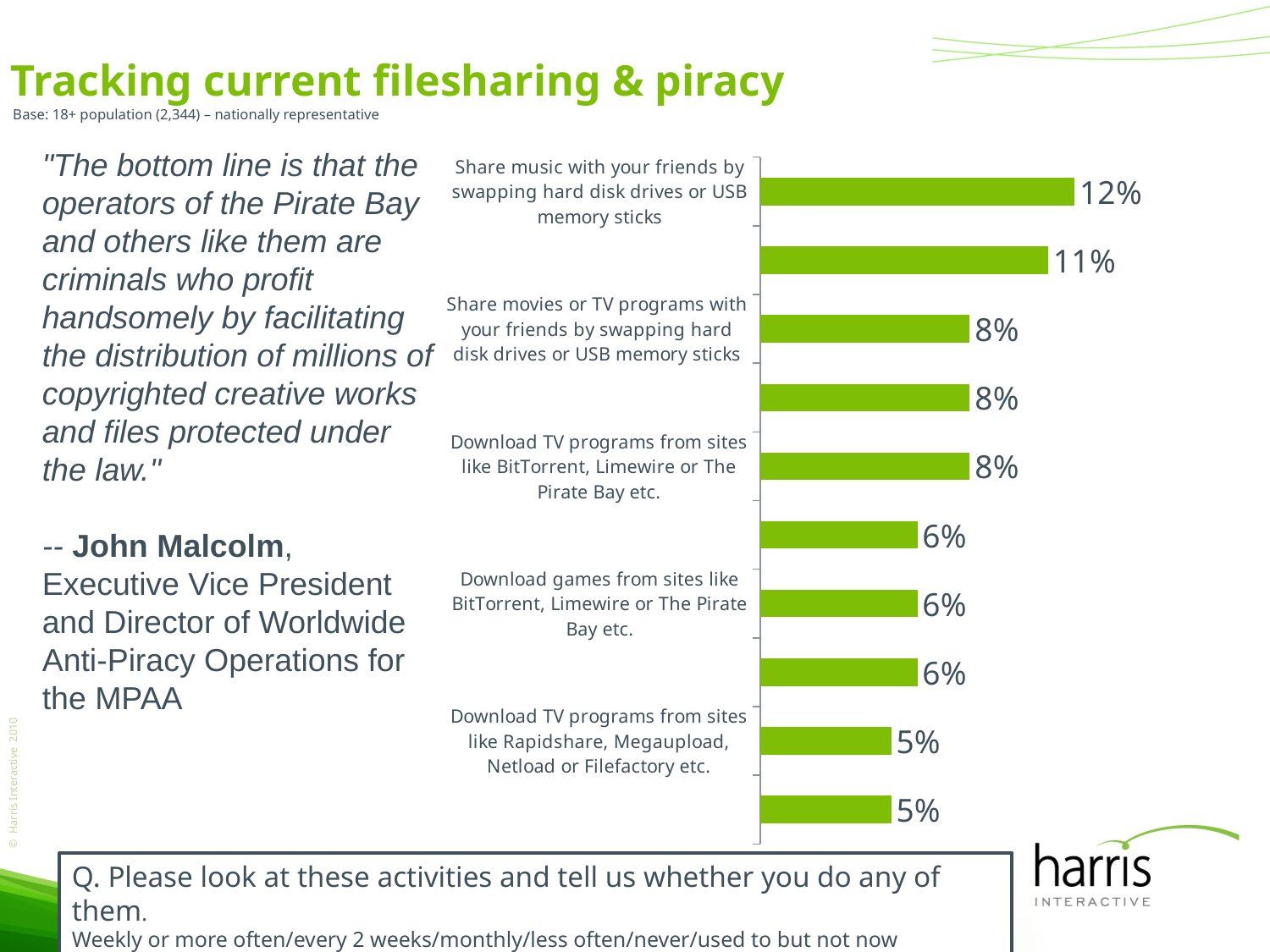
What is the difference between the value for sharing music by swapping hard disk drives or USB memory sticks and the value for downloading games from sites like BitTorrent, Limewire or The Pirate Bay? 6% What kind of chart is shown on the slide? bar chart Do the bar values increase or decrease going from the top of the chart to the bottom? decrease What is the value for 'Download games from sites like BitTorrent, Limewire or The Pirate Bay etc.'? 6% What is the value for 'Download TV programs from sites like Rapidshare, Megaupload, Netload or Filefactory etc.'? 5% What is the value for 'Share movies or TV programs with your friends by swapping hard disk drives or USB memory sticks'? 8% What is the value for 'Download TV programs from sites like BitTorrent, Limewire or The Pirate Bay etc.'? 8% What is the lowest value shown in the chart? 5% How many bars are plotted in the chart? 10 Which activity has the highest value in the chart? Share music with your friends by swapping hard disk drives or USB memory sticks What percentage of respondents share music with their friends by swapping hard disk drives or USB memory sticks? 12% Which is larger: the value for sharing music by swapping hard disk drives or USB memory sticks, or the value for downloading TV programs from sites like Rapidshare, Megaupload, Netload or Filefactory? Share music with your friends by swapping hard disk drives or USB memory sticks